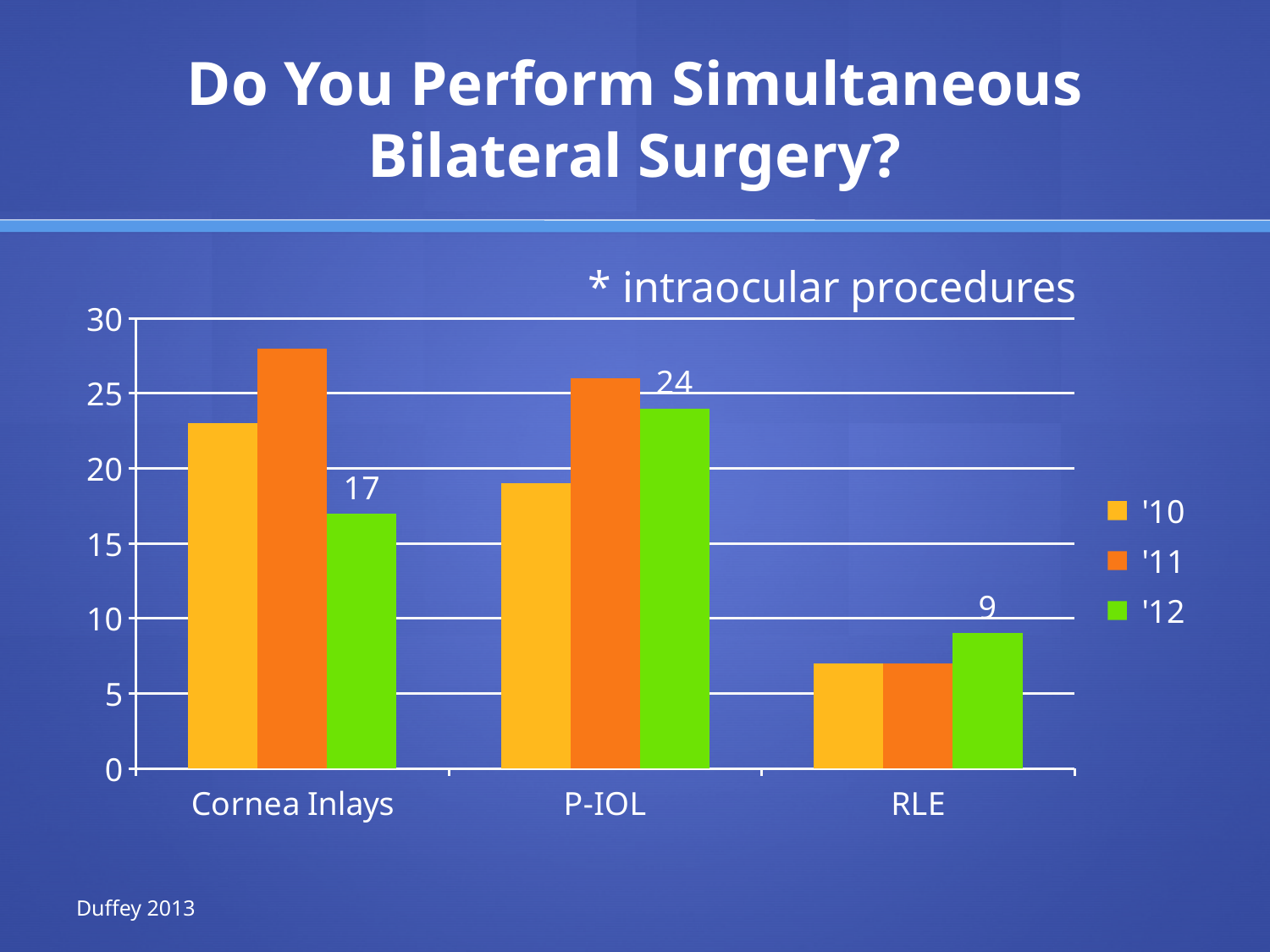
Which category has the highest value for the '12 series? P-IOL Is the value for '10 in the RLE category greater or less than 10? less What is the value for '12 in the Cornea Inlays category? 17 Which is larger for the '12 series: Cornea Inlays or RLE? Cornea Inlays Which category has the lowest value for the '12 series? RLE What kind of chart is shown on the slide? Bar chart Is the value for '11 in the Cornea Inlays category greater or less than 25? greater How many categories are shown on the x axis? 3 How many series does the legend list? 3 What is the value for '12 in the RLE category? 9 What is the value for '12 in the P-IOL category? 24 What is the difference between the '12 values for P-IOL and Cornea Inlays? 7